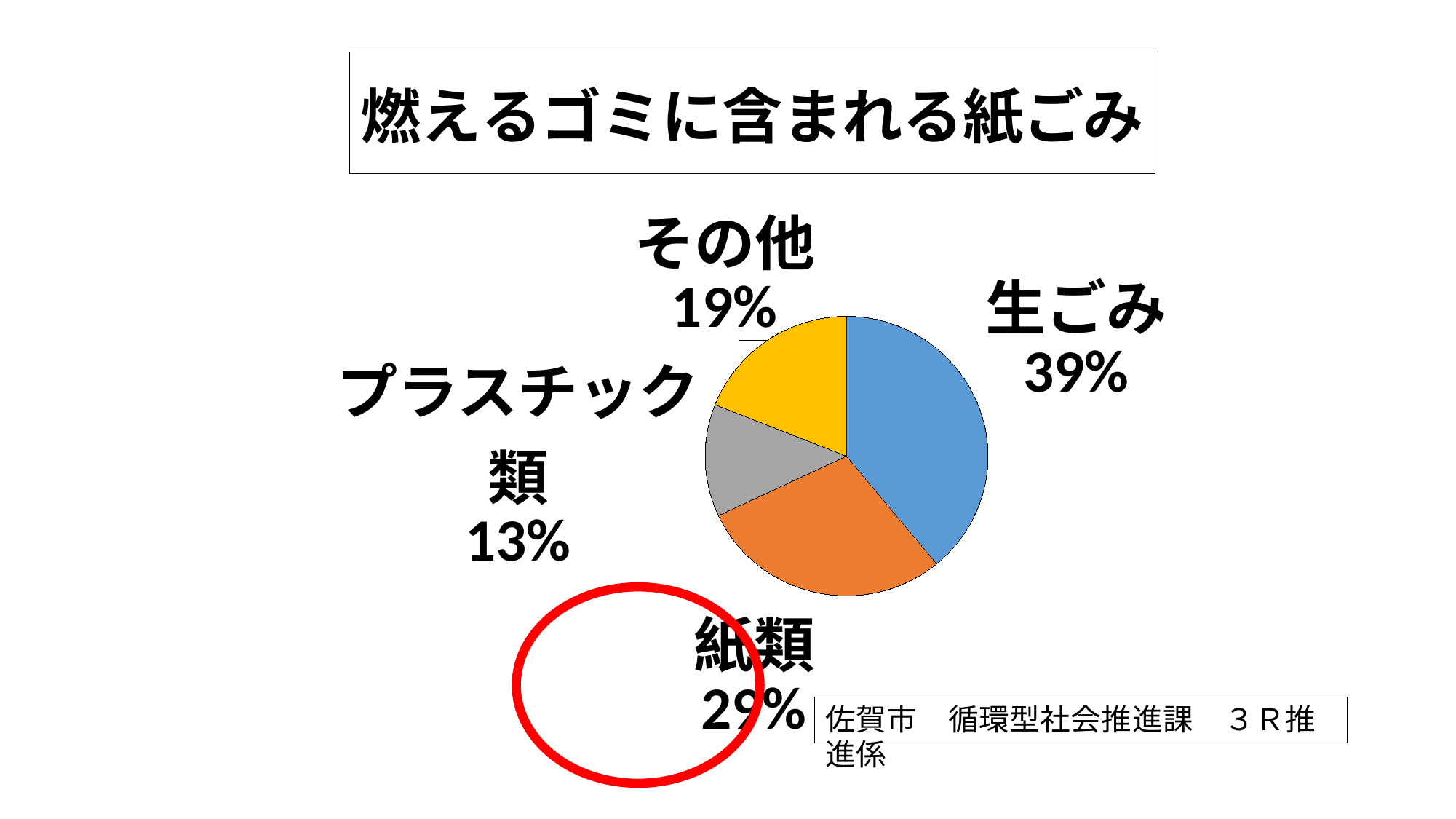
Which category has the smallest share of the pie? プラスチック類 Which is larger, その他 or プラスチック類? その他 What is the title of the chart? 燃えるゴミに含まれる紙ごみ What percentage of the pie is 紙類? 29% What colour is the 生ごみ slice? blue What percentage of the pie is プラスチック類? 13% What percentage of the pie is 生ごみ? 39% What is the difference in percentage points between 生ごみ and 紙類? 10 Which category has the largest share of the pie? 生ごみ What kind of chart is shown on the slide? pie chart What percentage of the pie is その他? 19% How many slices does the pie chart have? 4